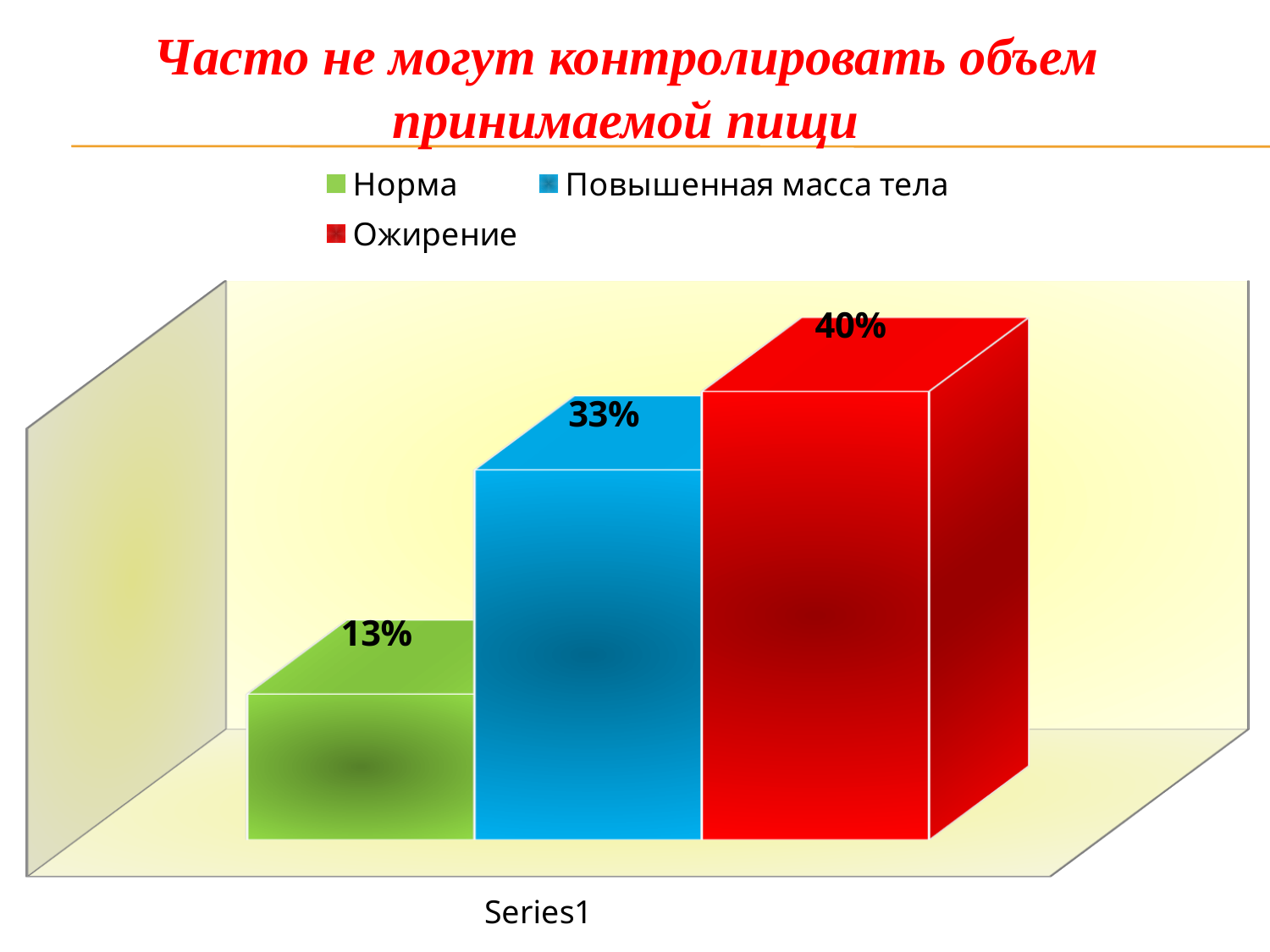
What is the difference between the values for Ожирение and Повышенная масса тела? 7% What kind of chart is shown on the slide? bar chart What is the value for Повышенная масса тела? 33% Which series has the lowest value? Норма What is the difference between the values for Ожирение and Норма? 27% What colour is the bar for Ожирение? red Which is larger, the value for Повышенная масса тела or the value for Норма? Повышенная масса тела How many series does the legend list? 3 What is the value for Ожирение? 40% How many bars are plotted on the chart? 3 What is the value for Норма? 13% Which series has the highest value? Ожирение